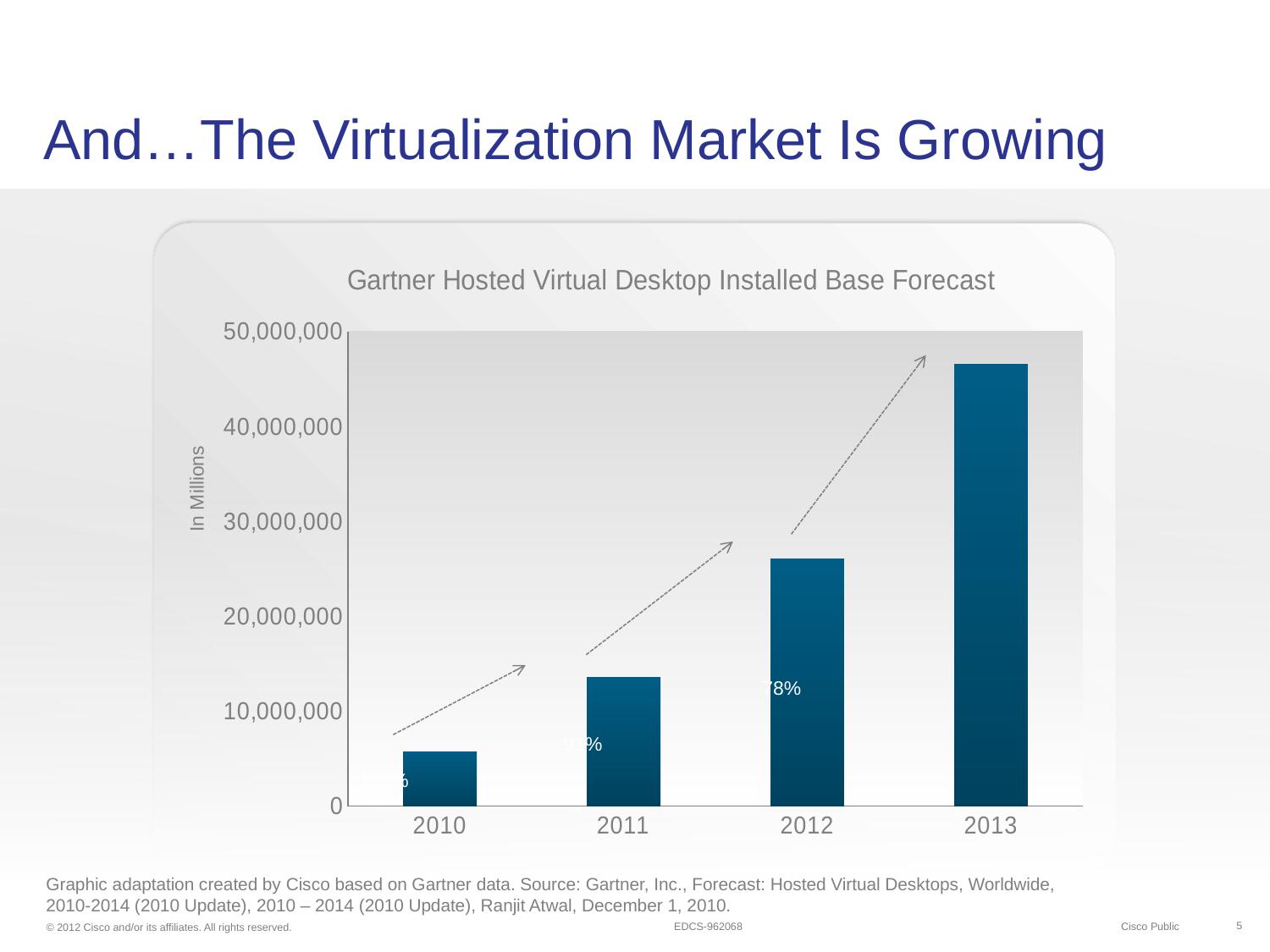
Is the value for 2011 greater or less than 10,000,000? greater What kind of chart is shown on the slide? bar chart Which is larger, the value for 2011 or the value for 2012? 2012 Is the value for 2012 greater or less than 20,000,000? greater Which year has the lowest installed base in the chart? 2010 What is the title of the chart? Gartner Hosted Virtual Desktop Installed Base Forecast Is the value for 2013 greater or less than 40,000,000? greater Do the values rise or fall from 2010 to 2013? rise Which year has the highest installed base in the chart? 2013 How many years are shown on the x axis of the chart? 4 What is the label on the vertical axis of the chart? In Millions